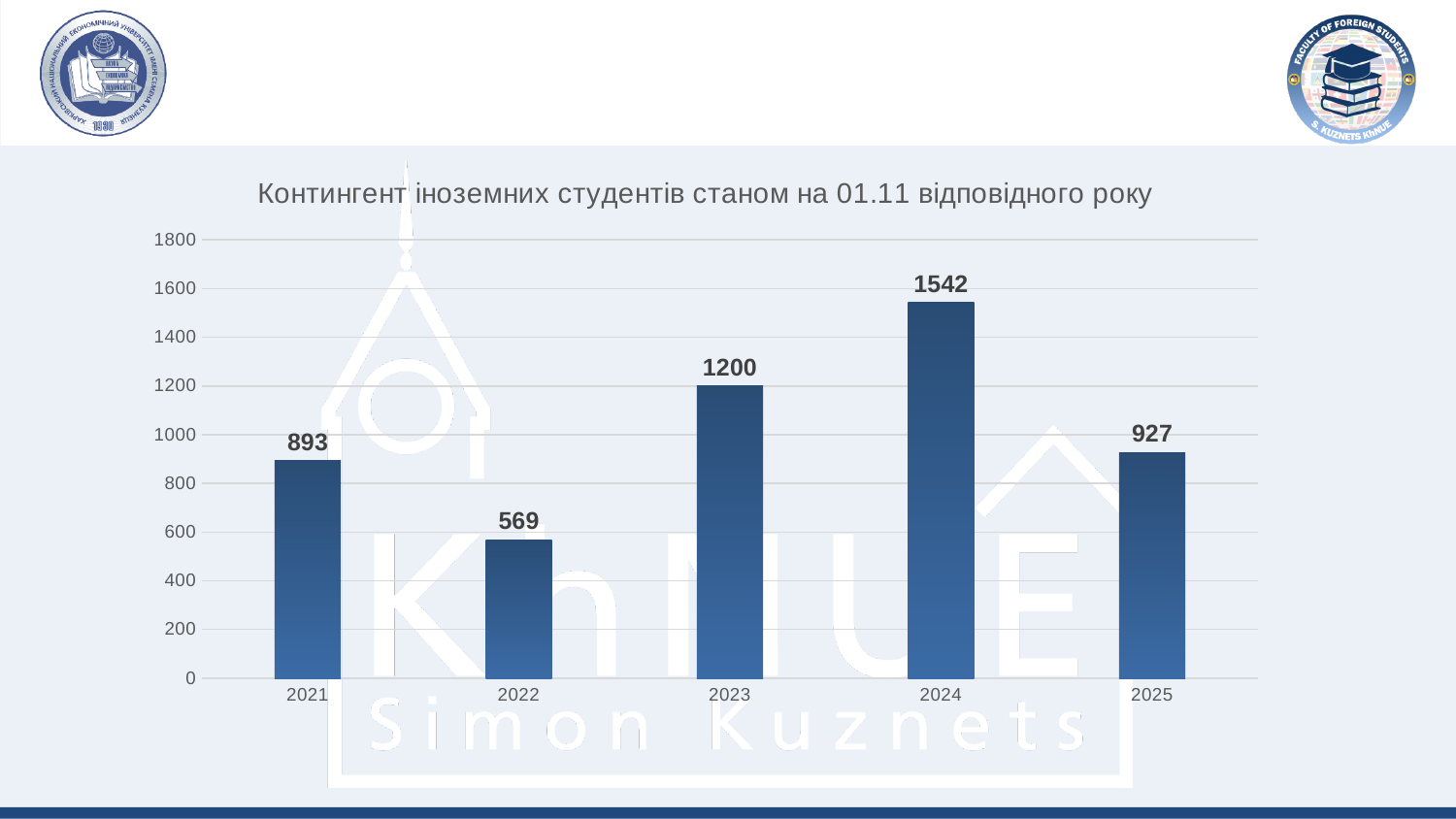
What kind of chart is shown on the slide? bar chart What is the value for 2021? 893 What is the difference between the values for 2024 and 2023? 342 How many years are shown on the x axis? 5 Is the value for 2022 greater or less than 600? less Which year has the highest value? 2024 Which is larger, the value for 2023 or the value for 2025? 2023 What is the title of the chart? Контингент іноземних студентів станом на 01.11 відповідного року What is the value for 2022? 569 What is the value for 2024? 1542 Which year has the lowest value? 2022 What is the difference between the values for 2025 and 2021? 34